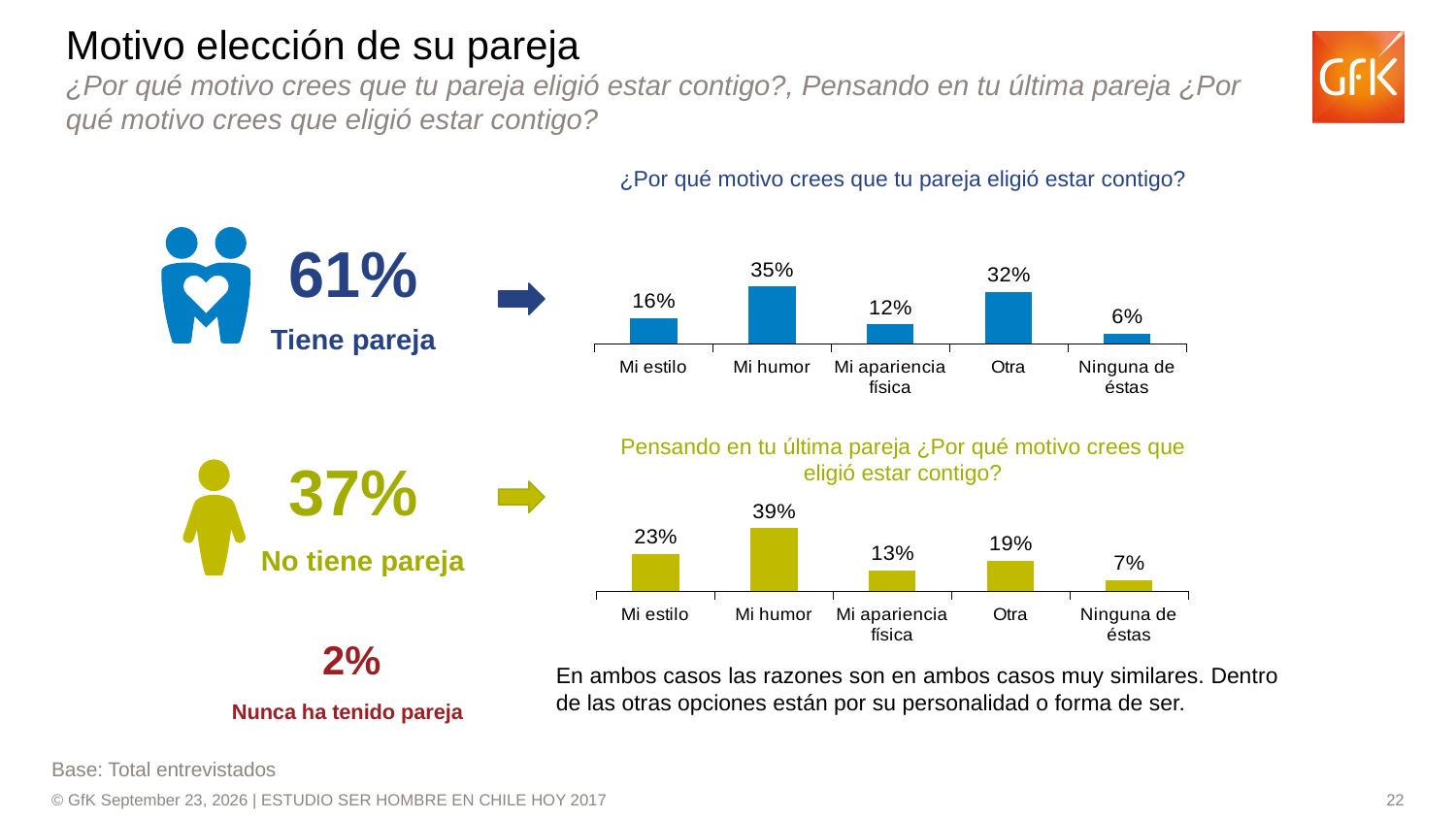
What colour are the bars in the bottom chart (Pensando en tu última pareja ¿Por qué motivo crees que eligió estar contigo?)? Yellow-green In the top chart (¿Por qué motivo crees que tu pareja eligió estar contigo?), what is the value for Mi humor? 35% In the bottom chart (Pensando en tu última pareja ¿Por qué motivo crees que eligió estar contigo?), which category has the highest value? Mi humor In the bottom chart (Pensando en tu última pareja ¿Por qué motivo crees que eligió estar contigo?), what is the value for Otra? 19% In the bottom chart (Pensando en tu última pareja ¿Por qué motivo crees que eligió estar contigo?), what is the value for Mi estilo? 23% In the top chart (¿Por qué motivo crees que tu pareja eligió estar contigo?), which category has the highest value? Mi humor In the top chart (¿Por qué motivo crees que tu pareja eligió estar contigo?), which category has the lowest value? Ninguna de éstas In the top chart (¿Por qué motivo crees que tu pareja eligió estar contigo?), what is the difference between Mi humor and Otra? 3% What type of chart is the bottom chart (Pensando en tu última pareja ¿Por qué motivo crees que eligió estar contigo?)? Bar chart In the top chart (¿Por qué motivo crees que tu pareja eligió estar contigo?), which is larger: Mi estilo or Mi apariencia física? Mi estilo How many categories does the top chart (¿Por qué motivo crees que tu pareja eligió estar contigo?) show? 5 In the bottom chart (Pensando en tu última pareja ¿Por qué motivo crees que eligió estar contigo?), what is the difference between Mi humor and Mi apariencia física? 26%